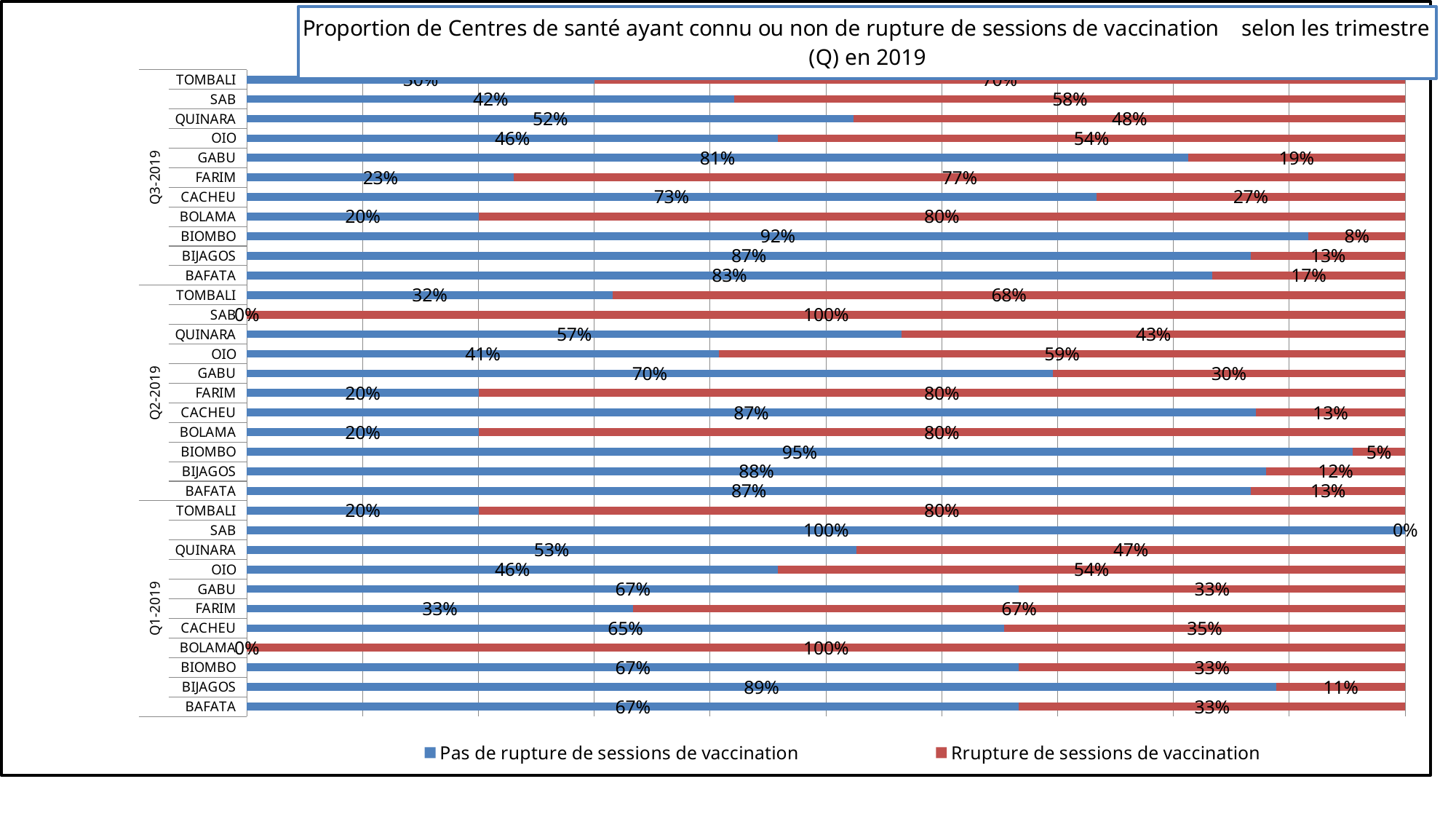
What is the value of "Rrupture de sessions de vaccination" for FARIM in Q1-2019? 67% What is the value of "Pas de rupture de sessions de vaccination" for BIOMBO in Q2-2019? 95% How many series does the legend list? 2 In Q1-2019, which region has the lowest value for "Pas de rupture de sessions de vaccination"? BOLAMA Which legend entry is shown in blue? Pas de rupture de sessions de vaccination What is the total of the stacked bar for CACHEU in Q2-2019? 100% What is the value of "Rrupture de sessions de vaccination" for SAB in Q1-2019? 0% In Q3-2019, which region has the highest value for "Pas de rupture de sessions de vaccination"? BIOMBO For GABU in Q3-2019, what is the difference between "Pas de rupture de sessions de vaccination" and "Rrupture de sessions de vaccination"? 62 percentage points How many regions are listed for each quarter in the chart? 11 What kind of chart is shown on the slide? Stacked bar chart In Q2-2019, which has the larger value for "Pas de rupture de sessions de vaccination": QUINARA or OIO? QUINARA